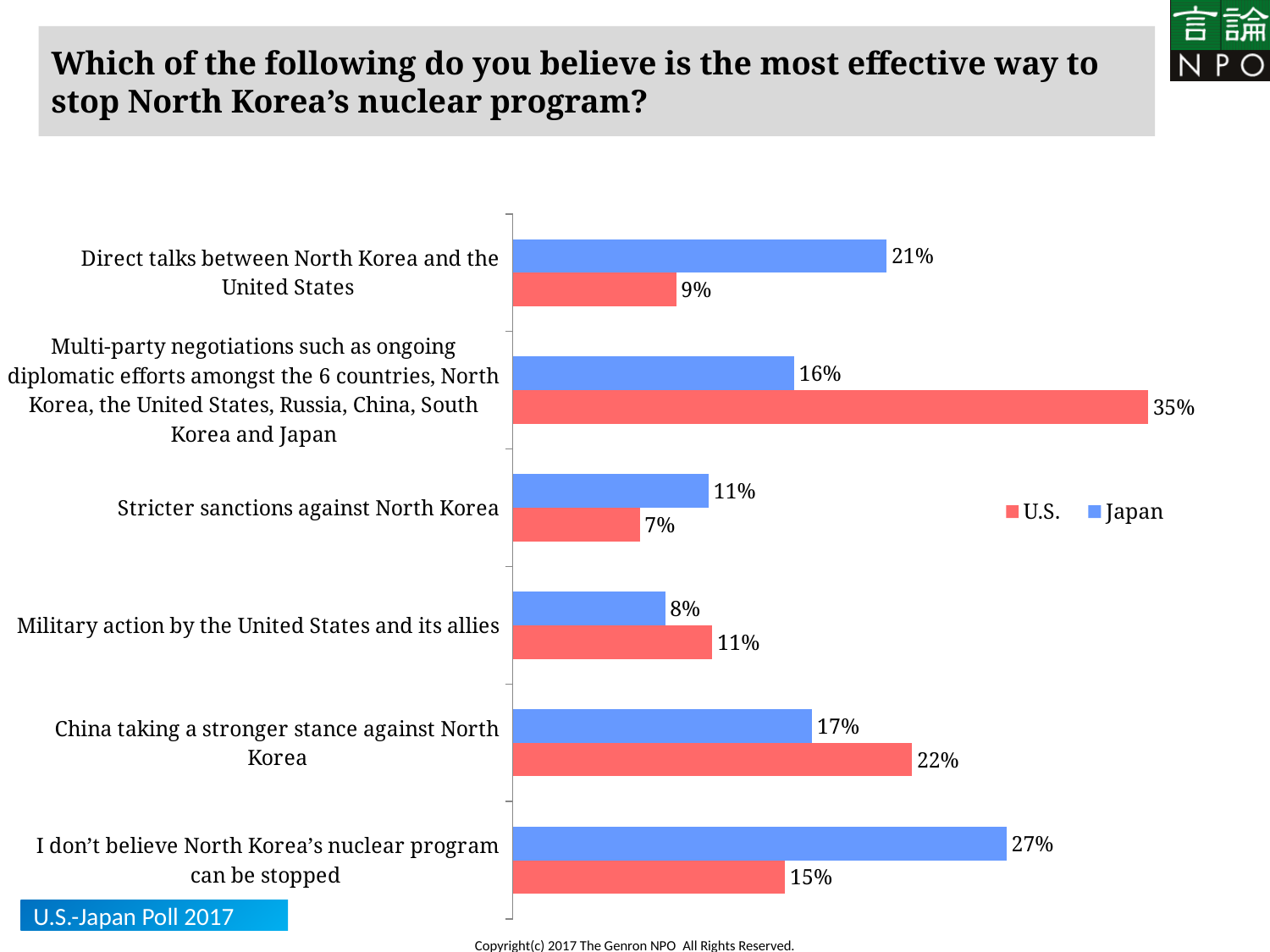
How many series does the legend list? 2 Which option has the highest value for U.S. respondents? Multi-party negotiations such as ongoing diplomatic efforts amongst the 6 countries What kind of chart is shown on the slide? Bar chart For China taking a stronger stance against North Korea, which is larger: the U.S. value or the Japan value? U.S. What is the difference between the Japan and U.S. values for 'I don't believe North Korea's nuclear program can be stopped'? 12% What is the difference between the U.S. and Japan values for multi-party negotiations? 19% Which option has the lowest value for Japanese respondents? Military action by the United States and its allies What percentage of U.S. respondents chose multi-party negotiations? 35% What is the U.S. value for stricter sanctions against North Korea? 7% Which colour represents Japan in the chart? Blue What percentage of Japanese respondents chose direct talks between North Korea and the United States? 21% How many response options are shown in the chart? 6